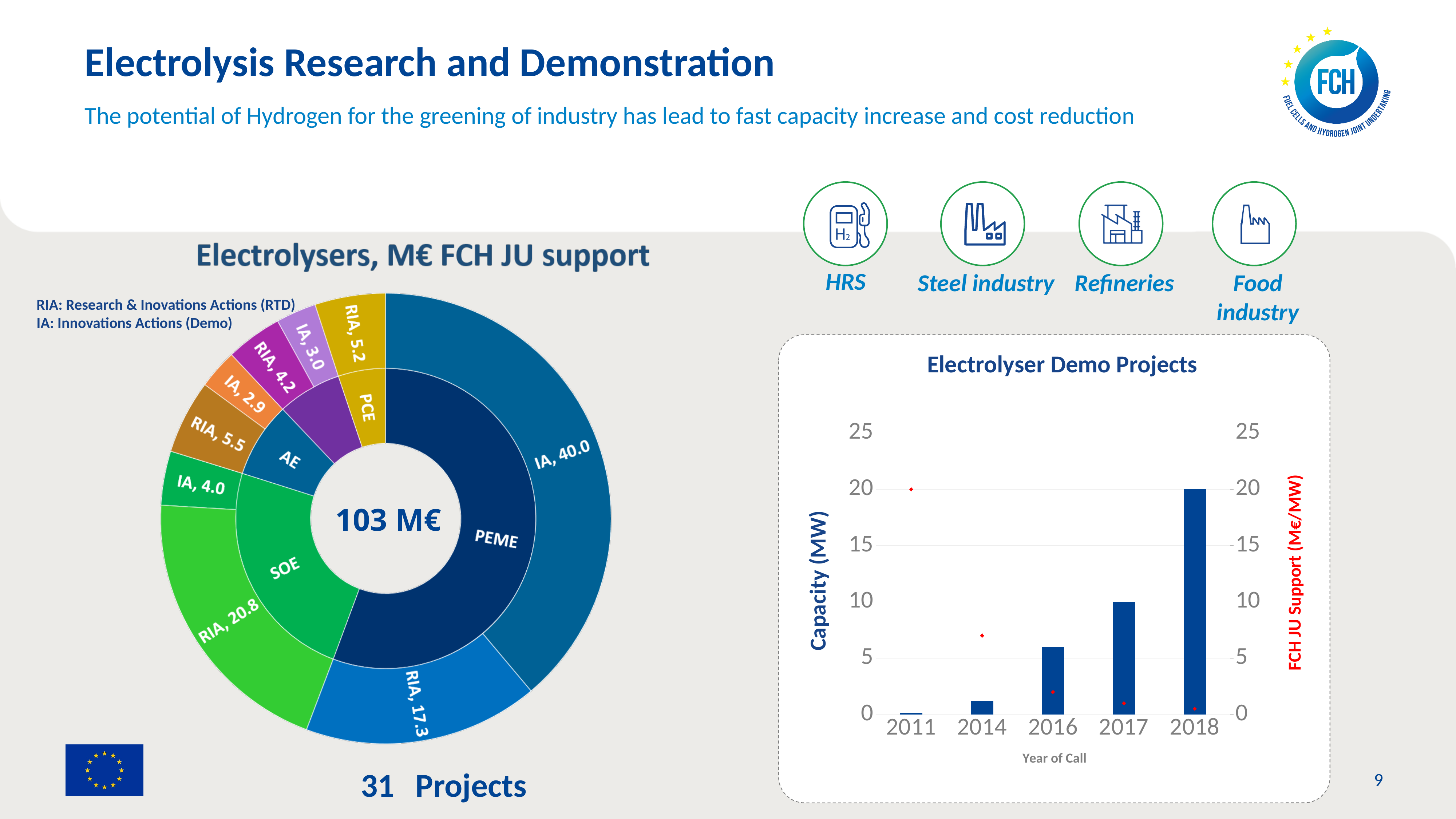
In the 'Electrolyser Demo Projects' chart, which year of call has the highest capacity? 2018 In the 'Electrolyser Demo Projects' chart, is the capacity for 2016 greater or less than 10 MW? less In the 'Electrolysers, M€ FCH JU support' doughnut chart, which outer-ring segment has the largest value? IA, 40.0 In the 'Electrolyser Demo Projects' chart, does capacity rise or fall from 2011 to 2018? rise In the 'Electrolysers, M€ FCH JU support' doughnut chart, what is the value of the RIA segment within PEME? 17.3 In the 'Electrolysers, M€ FCH JU support' doughnut chart, what total is shown in the centre? 103 M€ In the 'Electrolysers, M€ FCH JU support' doughnut chart, what is the difference between the IA (40.0) and RIA (17.3) segments of PEME? 22.7 In the 'Electrolysers, M€ FCH JU support' doughnut chart, what is the value of the IA segment within PEME? 40.0 In the 'Electrolyser Demo Projects' chart, how many years of call are shown on the x axis? 5 In the 'Electrolysers, M€ FCH JU support' doughnut chart, what is the value of the RIA segment within SOE? 20.8 In the 'Electrolysers, M€ FCH JU support' doughnut chart, how many technology categories are shown in the inner ring? 4 In the 'Electrolyser Demo Projects' chart, is the capacity for 2018 greater or less than 15 MW? greater